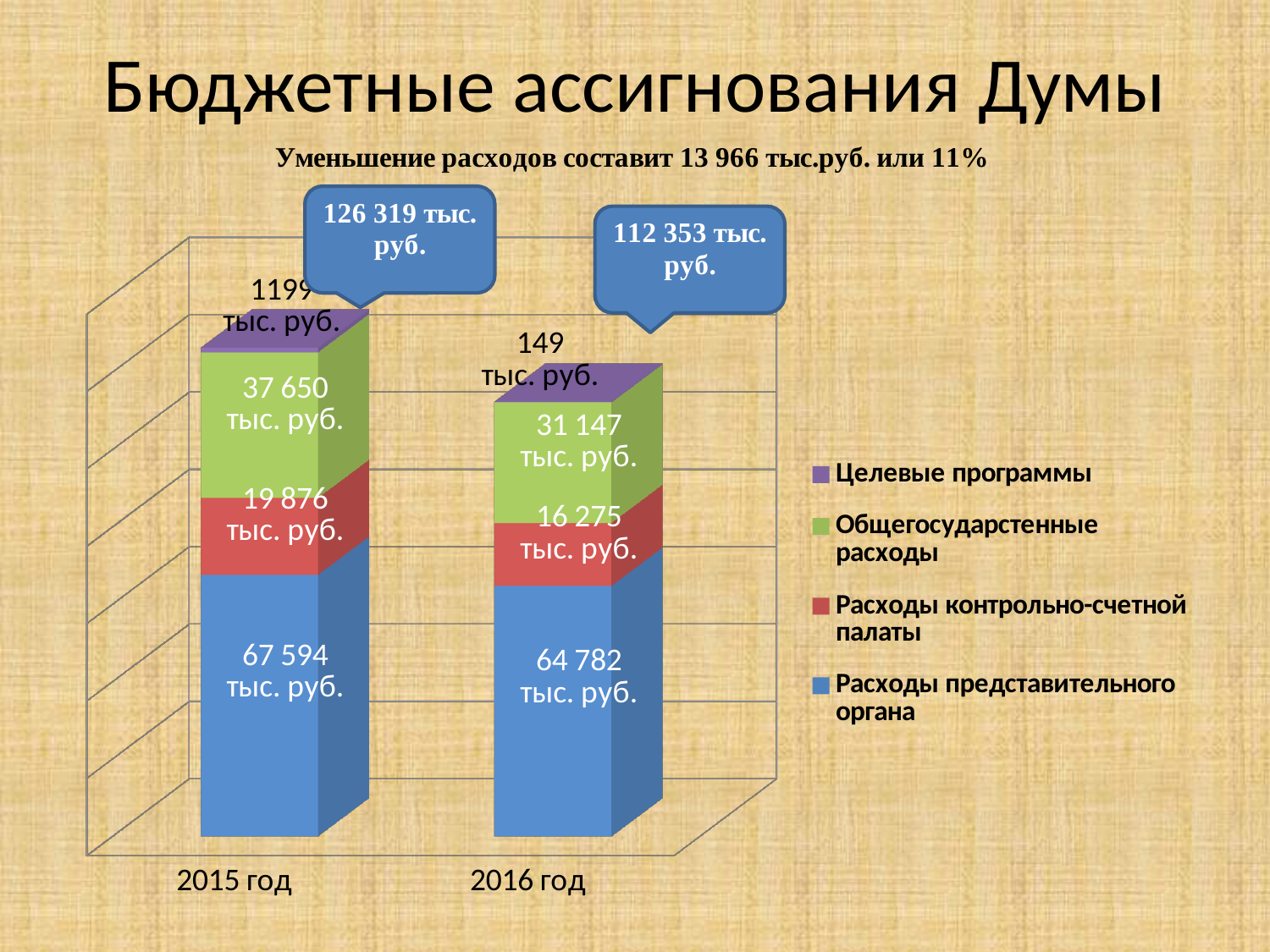
What is the value for Расходы контрольно-счетной палаты in 2015 год? 19 876 тыс. руб. What is the total of the stacked bar for 2016 год? 112 353 тыс. руб. What is the total of the stacked bar for 2015 год? 126 319 тыс. руб. What is the difference between the total for 2015 год and the total for 2016 год? 13 966 тыс. руб. Which year has the larger value for Расходы представительного органа, 2015 год or 2016 год? 2015 год What kind of chart is shown on the slide? Stacked bar chart What is the value for Общегосударстенные расходы in 2016 год? 31 147 тыс. руб. How many series does the legend list? 4 What is the value for Целевые программы in 2016 год? 149 тыс. руб. Which series has the smallest value in 2016 год? Целевые программы What is the value for Расходы представительного органа in 2015 год? 67 594 тыс. руб. What is the title of the slide? Бюджетные ассигнования Думы